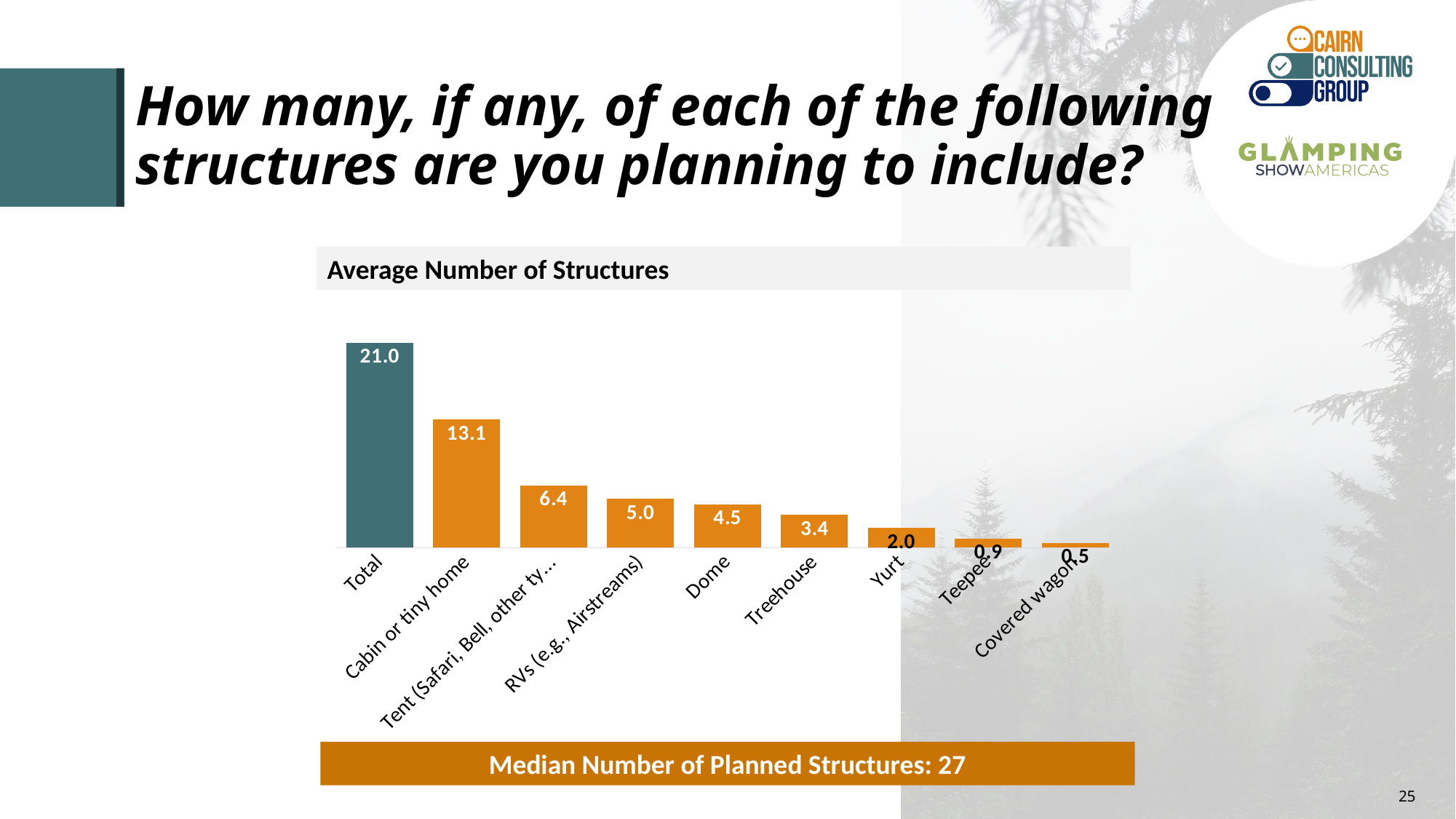
Excluding the Total bar, which structure type has the highest average number? Cabin or tiny home Which structure type has the lowest average number? Covered wagon What type of chart is shown on the slide? Bar chart What is the median number of planned structures stated on the slide? 27 What is the average number of structures for Cabin or tiny home? 13.1 What is the value shown for Dome? 4.5 Do the values rise or fall moving from left to right along the x axis? Fall What is the difference between the values for Cabin or tiny home and Yurt? 11.1 What is the value shown for the Total bar? 21.0 What is the value shown for Treehouse? 3.4 Which has a larger value, Dome or Treehouse? Dome How many bars are shown in the chart? 9